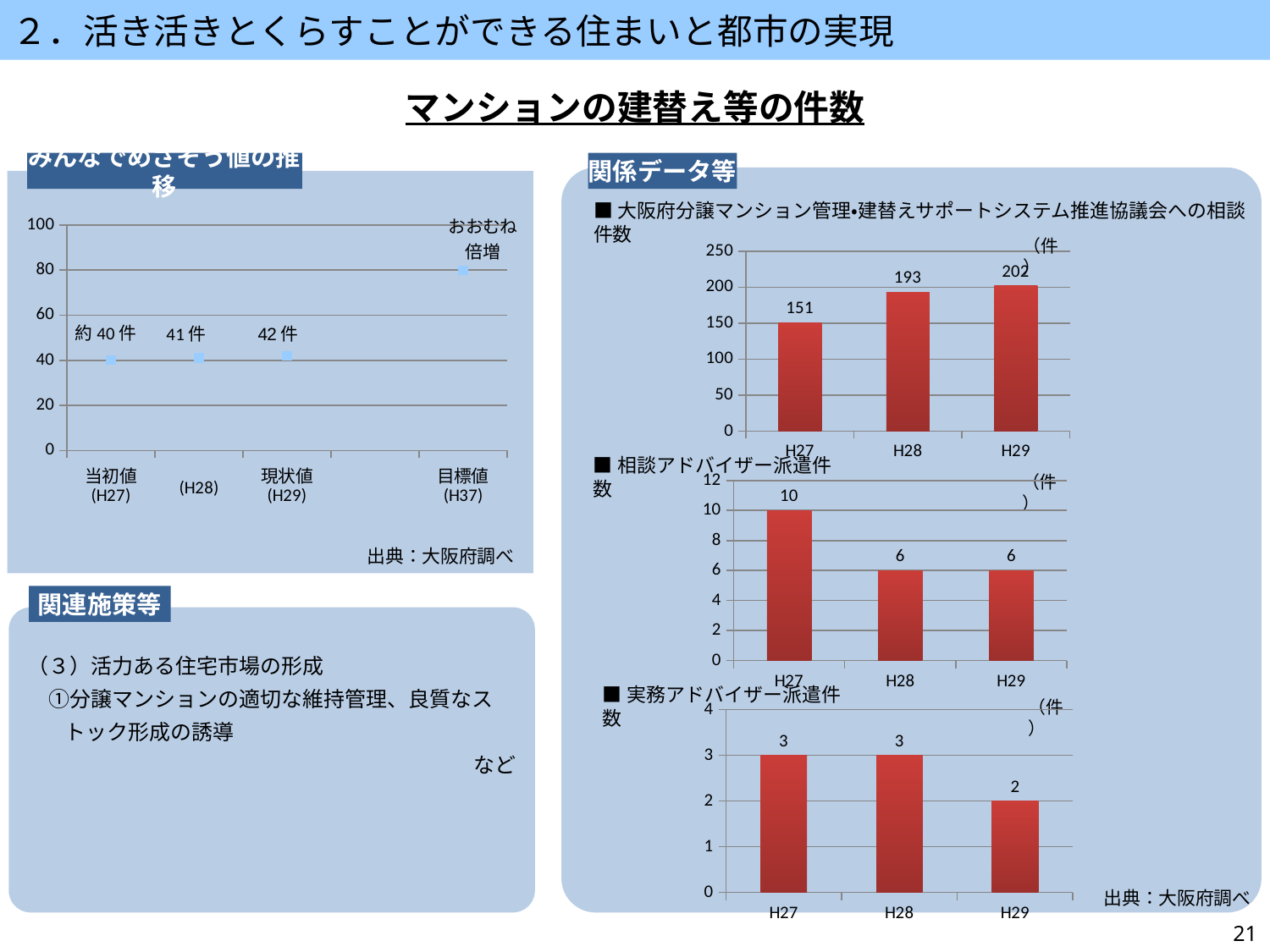
In the chart titled 相談アドバイザー派遣件数, what is the difference between the H27 and H28 values? 4 In the chart titled 実務アドバイザー派遣件数, which year has the lowest value? H29 In the chart titled 大阪府分譲マンション管理•建替えサポートシステム推進協議会への相談件数, what is the difference between the H29 and H27 values? 51 What kind of chart is the chart titled 相談アドバイザー派遣件数? bar chart In the chart titled 大阪府分譲マンション管理•建替えサポートシステム推進協議会への相談件数, do the values rise or fall from H27 to H29? rise In the chart titled 実務アドバイザー派遣件数, what is the value for H29? 2 In the chart titled みんなでめざそう値の推移 on the left, what is the value labelled for 現状値 (H29)? 42 件 In the chart titled 大阪府分譲マンション管理•建替えサポートシステム推進協議会への相談件数, what is the value for H28? 193 In the chart titled 大阪府分譲マンション管理•建替えサポートシステム推進協議会への相談件数, which year has the highest value? H29 In the chart titled 相談アドバイザー派遣件数, which year has the highest value? H27 In the chart titled 実務アドバイザー派遣件数, how many years are shown on the x axis? 3 In the chart titled 相談アドバイザー派遣件数, what is the value for H27? 10